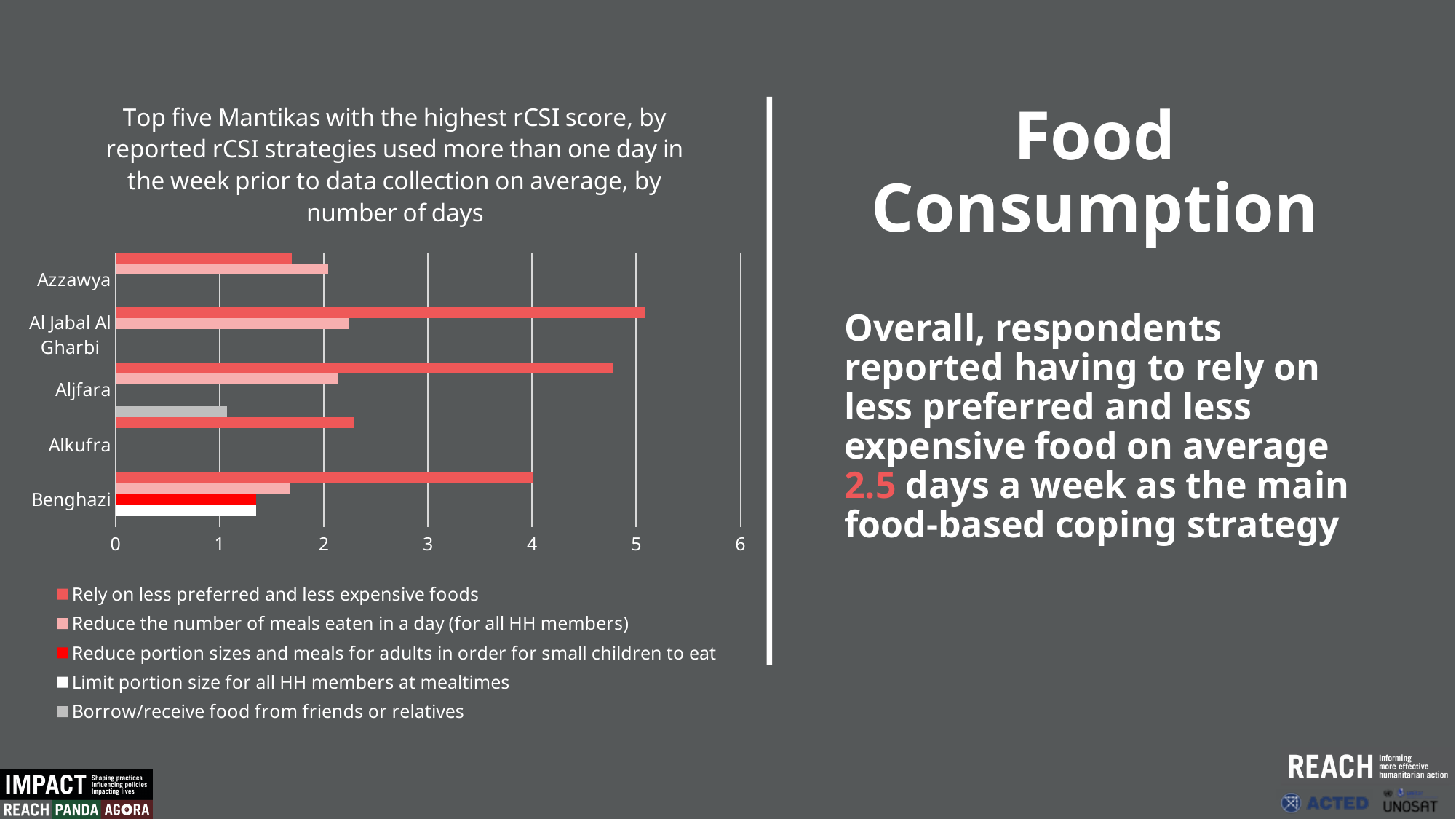
How many Mantikas (categories) are shown on the chart? 5 Which Mantika is the only one with a bar for 'Borrow/receive food from friends or relatives'? Aljfara Is the value for 'Rely on less preferred and less expensive foods' in Aljfara greater or less than 4? greater Is the value for 'Rely on less preferred and less expensive foods' in Al Jabal Al Gharbi greater or less than 4? greater Which Mantika has the highest value for 'Rely on less preferred and less expensive foods'? Al Jabal Al Gharbi Is the value for 'Reduce portion sizes and meals for adults in order for small children to eat' in Benghazi greater or less than 2? less What kind of chart is shown on the slide? bar chart Which Mantika has the lowest value for 'Rely on less preferred and less expensive foods'? Azzawya In Benghazi, which is larger: 'Rely on less preferred and less expensive foods' or 'Reduce the number of meals eaten in a day (for all HH members)'? Rely on less preferred and less expensive foods In Azzawya, which is larger: 'Rely on less preferred and less expensive foods' or 'Reduce the number of meals eaten in a day (for all HH members)'? Reduce the number of meals eaten in a day (for all HH members) How many series does the chart legend list? 5